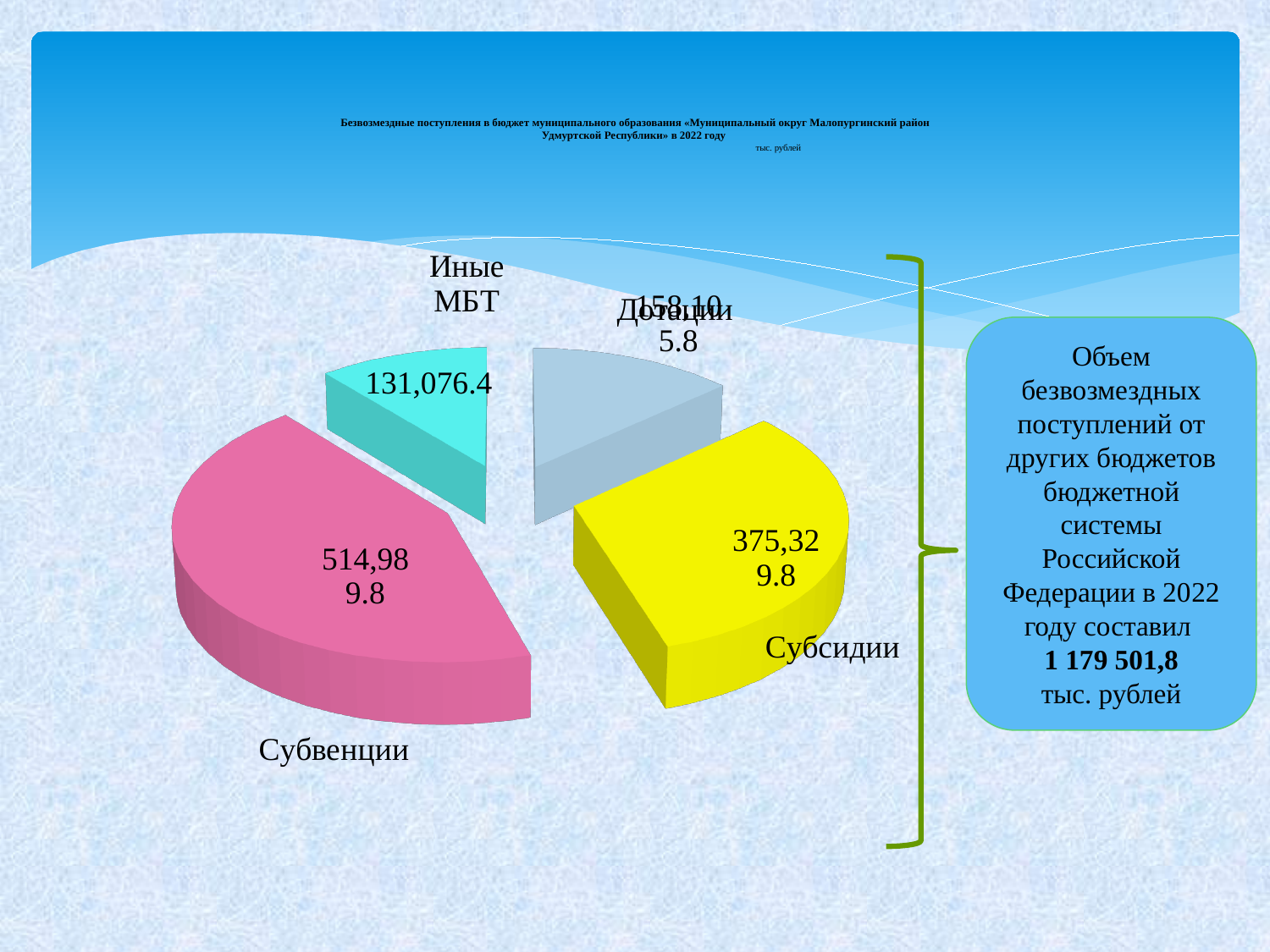
In what units are the chart values given, according to the chart title? тыс. рублей How many slices does the pie chart have? 4 What is the value shown for Субсидии? 375,329.8 What is the difference between the values for Субвенции and Субсидии? 139,660 Which is larger, Субвенции or Субсидии? Субвенции What kind of chart is shown on the slide? pie chart What is the value shown for Субвенции? 514,989.8 Which is larger, Субсидии or Иные МБТ? Субсидии Which category has the largest slice of the pie? Субвенции What is the value shown for Иные МБТ? 131,076.4 What is the difference between the values for Субсидии and Иные МБТ? 244,253.4 What colour is the Субвенции slice? pink